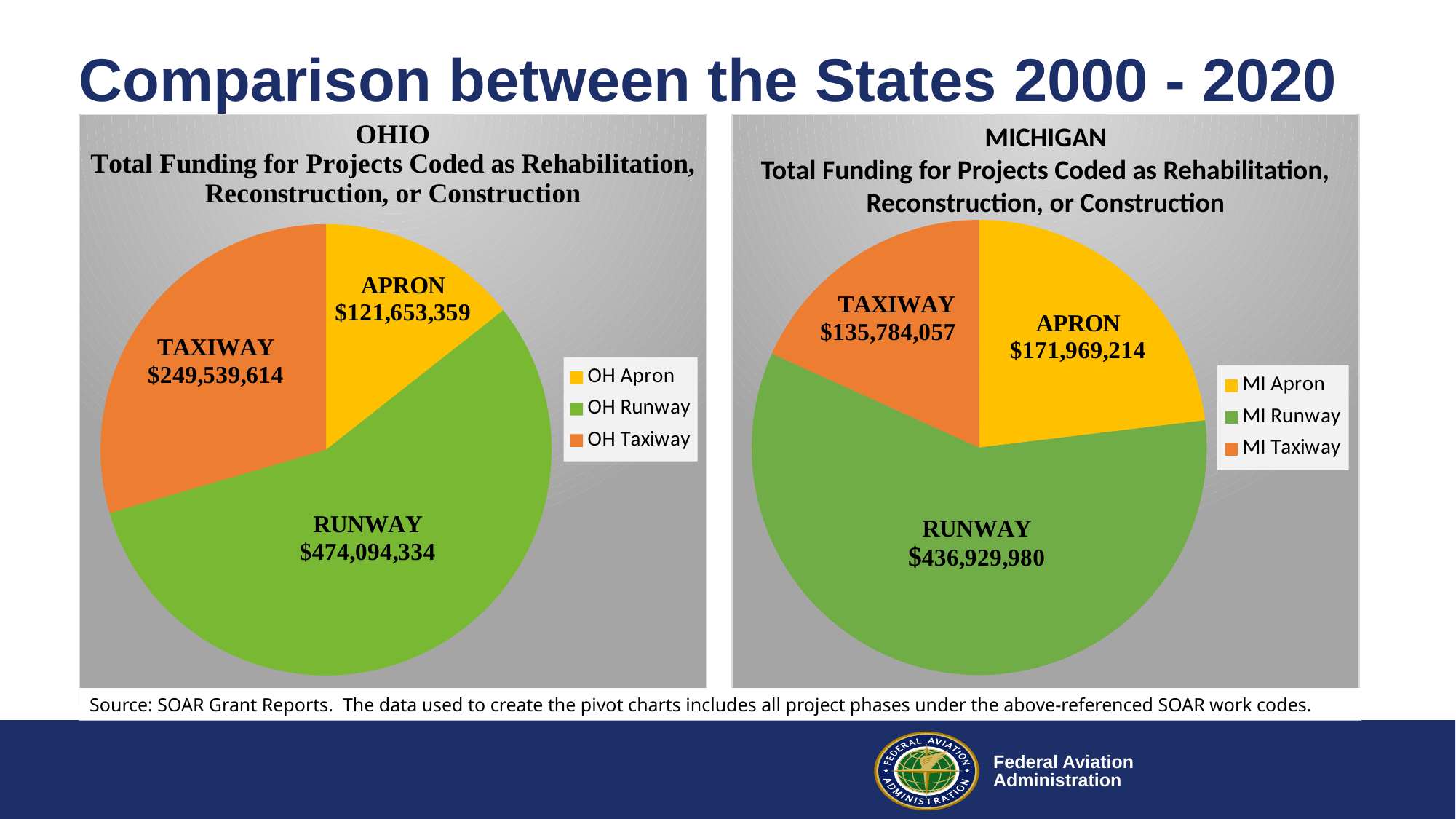
In the Ohio chart, which category has the largest funding? Runway In the Ohio chart, which category has the smallest funding? Apron In the Ohio chart, how much more funding did Taxiway projects receive than Apron projects? $127,886,255 How many slices does the Michigan pie chart have? 3 Which state shows higher Runway funding, Ohio or Michigan? Ohio In the Ohio chart, what is the total funding for Runway projects? $474,094,334 In the Michigan chart, what is the total funding for Taxiway projects? $135,784,057 In the Michigan chart, how much more funding did Apron projects receive than Taxiway projects? $36,185,157 What type of chart is used for the Ohio chart on the left? Pie chart In the Michigan chart, which category has the smallest funding? Taxiway How many entries does the legend of the Ohio chart list? 3 In the Michigan chart, what is the total funding for Apron projects? $171,969,214